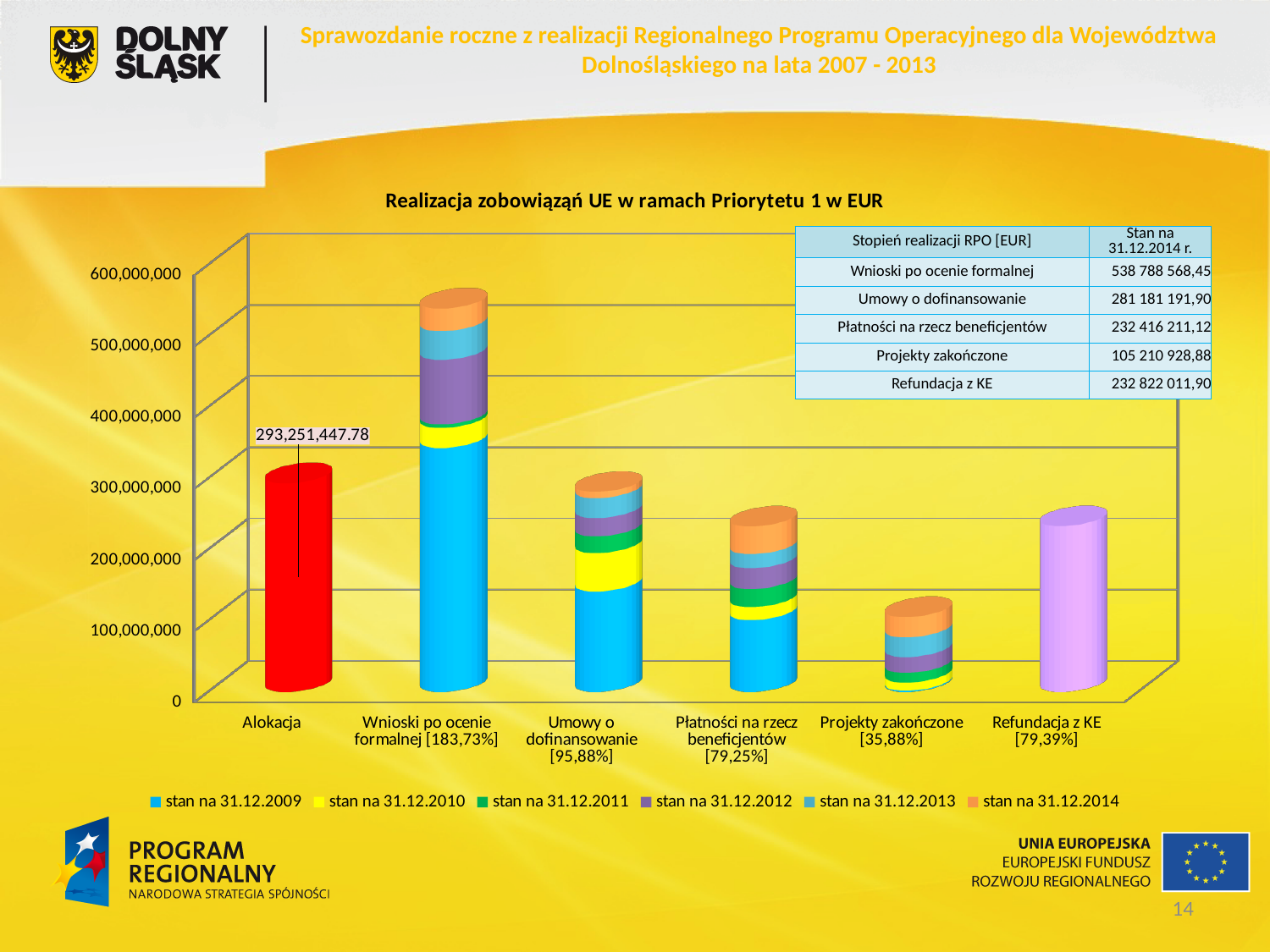
What percentage is shown in the x-axis label for Projekty zakończone? 35,88% Is the value for Projekty zakończone greater or less than 200,000,000? less What value is labelled on the Alokacja bar? 293,251,447.78 Which category has the highest bar? Wnioski po ocenie formalnej What kind of chart is shown on the slide? Stacked bar chart How many series does the legend list? 6 Is the value for Refundacja z KE greater or less than 200,000,000? greater Is the value for Wnioski po ocenie formalnej greater or less than 500,000,000? greater Which bar is taller: Umowy o dofinansowanie or Płatności na rzecz beneficjentów? Umowy o dofinansowanie Which category has the lowest bar? Projekty zakończone How many categories are shown on the x axis of the chart? 6 What is the title of the chart? Realizacja zobowiąząń UE w ramach Priorytetu 1 w EUR